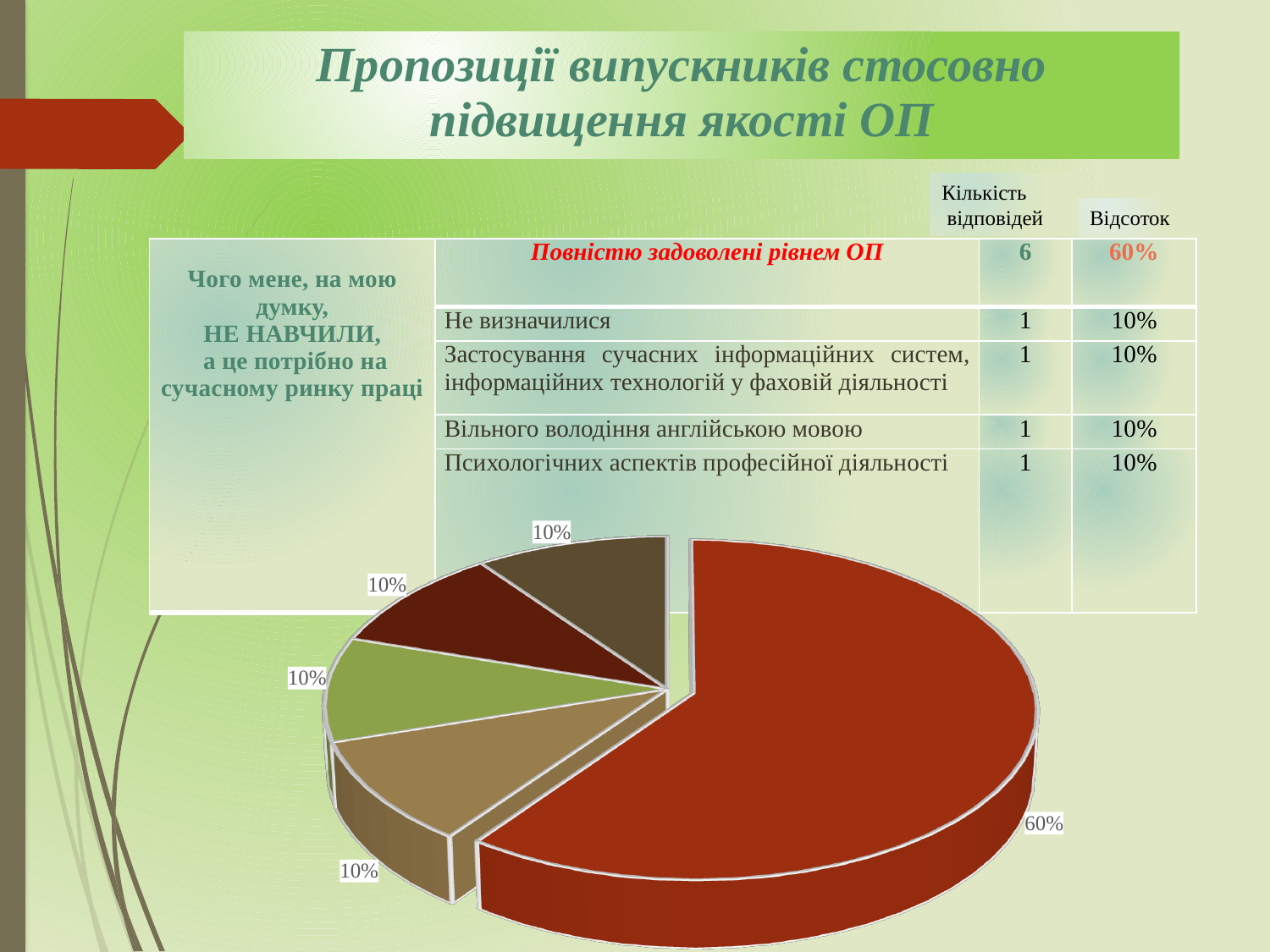
What is the smallest value labelled on the pie chart? 10% What colour is the largest slice of the pie chart? red What kind of chart is shown on the slide? pie chart What is the difference between the 60% slice and one of the 10% slices? 50% What is the combined share of the four 10% slices? 40% How many slices of the pie chart are labelled 10%? 4 What is the largest value labelled on the pie chart? 60% Does the pie chart display a legend? No Is the share of the largest slice greater or less than 50%? greater Which is larger, the red slice or the green slice? the red slice How many slices does the pie chart have? 5 What share of the pie does the large red slice represent? 60%